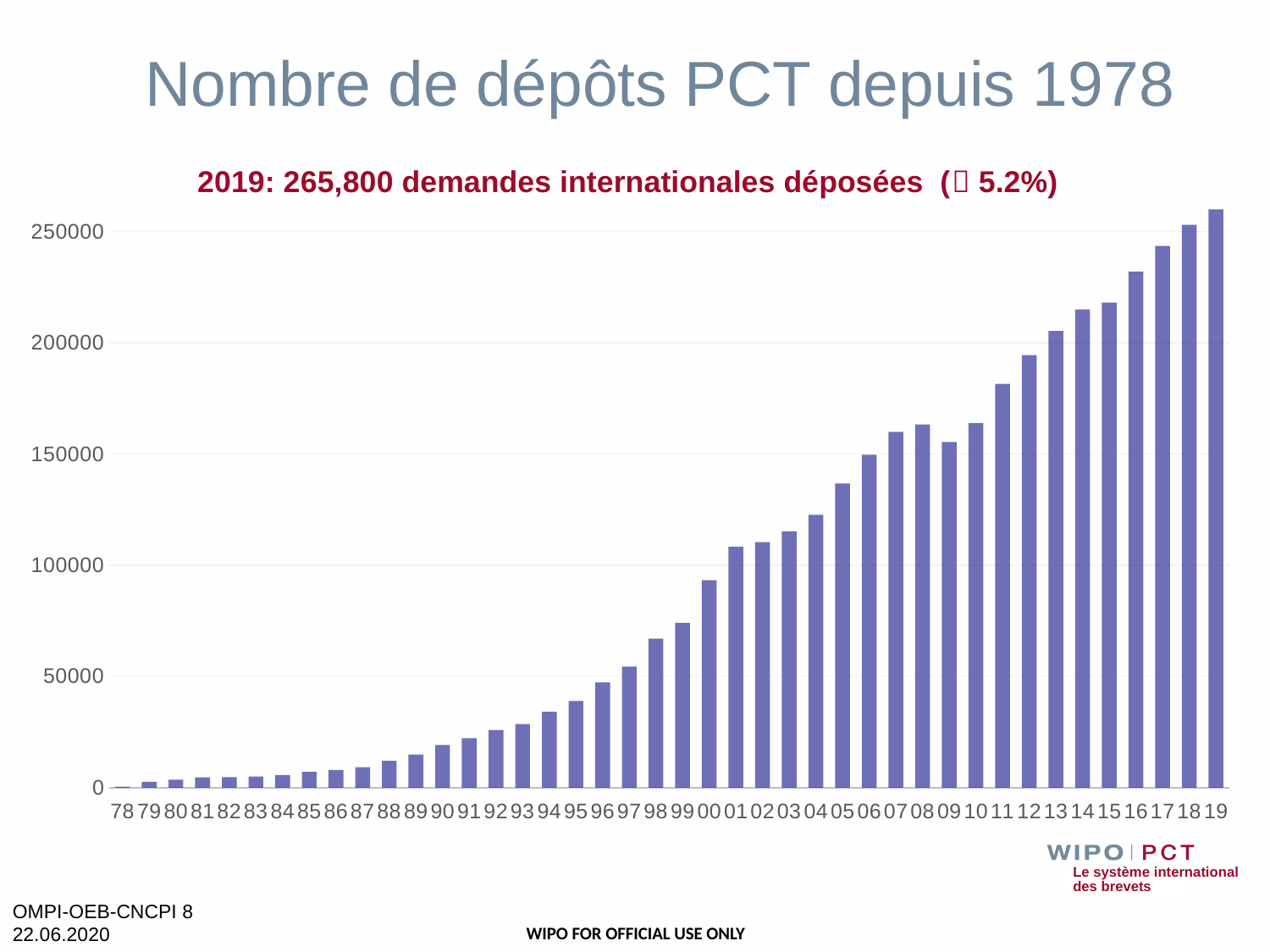
According to the subtitle, how many international applications were filed in 2019? 265,800 What kind of chart is shown on the slide? bar chart Which year has the larger value, 08 or 09? 08 How many years (bars) are plotted on the chart? 42 Is the value for 00 greater or less than 100000? less Which year has the lowest number of PCT filings? 78 What is the title of the chart? Nombre de dépôts PCT depuis 1978 Which year has the highest number of PCT filings? 19 Do the values generally rise or fall from 78 to 19 along the x axis? rise Is the value for 19 greater or less than 250000? greater Is the value for 05 greater or less than 150000? less What percentage change for 2019 is stated in the subtitle? 5.2%